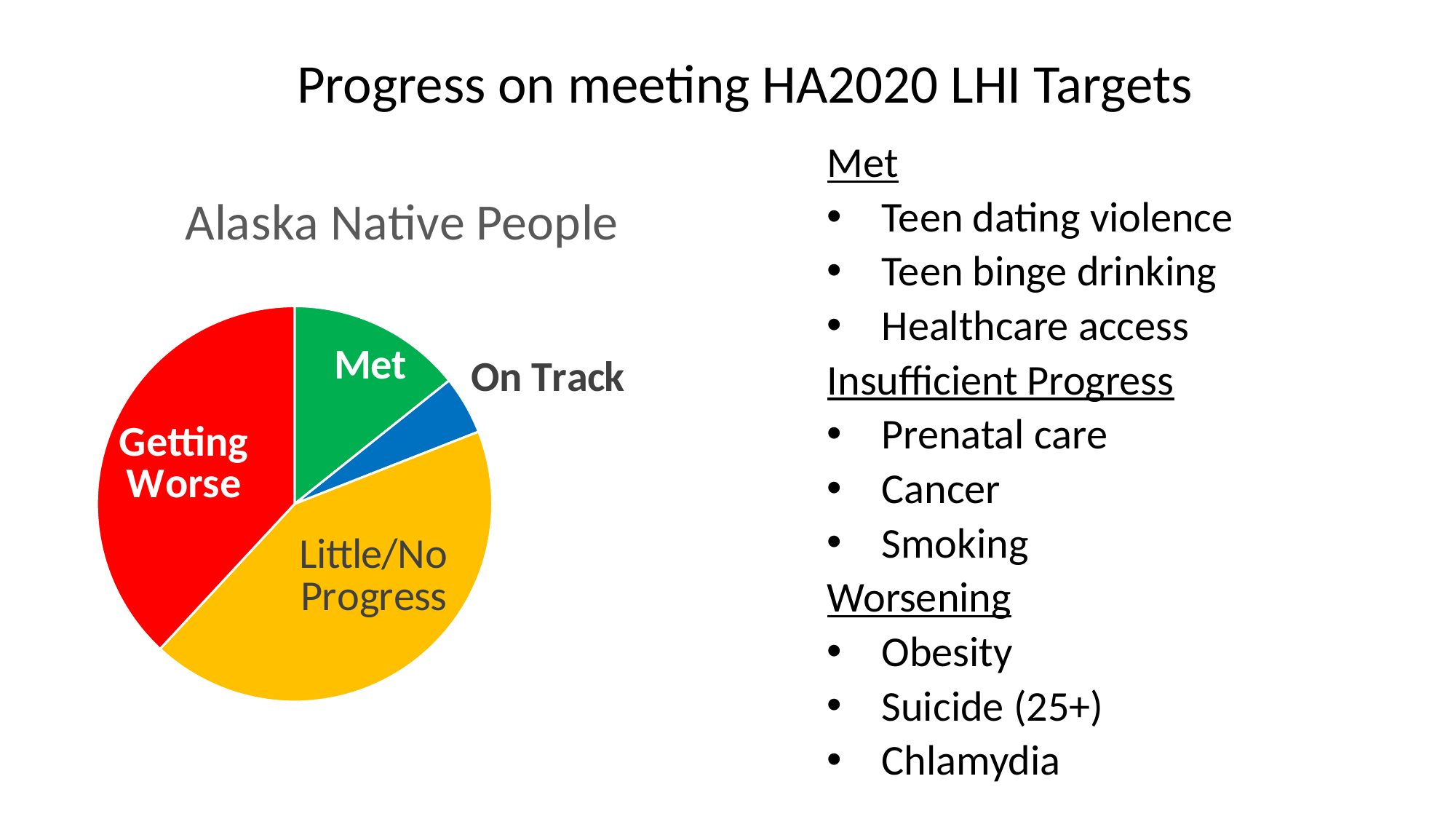
What is the title of the pie chart? Alaska Native People How many slices does the pie chart have? 4 Which slice is larger in the pie chart, Little/No Progress or On Track? Little/No Progress What kind of chart is shown on the slide? Pie chart What colour is the Getting Worse slice of the pie chart? Red Which slice is larger in the pie chart, Met or On Track? Met Which slice of the pie chart is the smallest? On Track Which slice is larger in the pie chart, Getting Worse or Met? Getting Worse